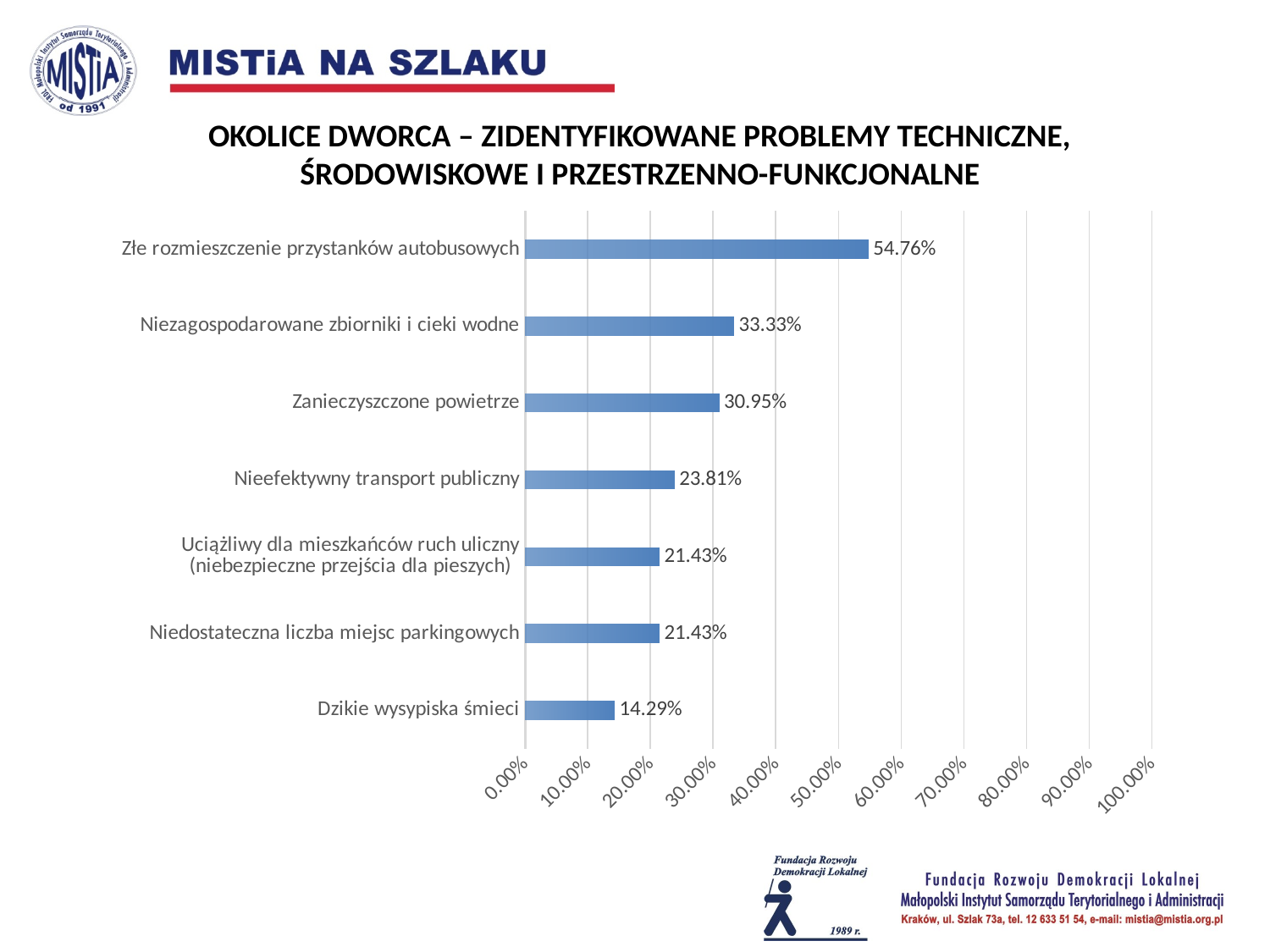
What is the value for "Zanieczyszczone powietrze"? 30.95% Which category has the lowest value? Dzikie wysypiska śmieci What is the difference between the values for "Złe rozmieszczenie przystanków autobusowych" and "Niezagospodarowane zbiorniki i cieki wodne"? 21.43% Which is larger: the value for "Nieefektywny transport publiczny" or the value for "Zanieczyszczone powietrze"? Zanieczyszczone powietrze What is the maximum value shown on the horizontal axis? 100.00% What is the value for "Złe rozmieszczenie przystanków autobusowych"? 54.76% How many categories are shown in the chart? 7 Is the value for "Niezagospodarowane zbiorniki i cieki wodne" greater or less than 30.00%? greater What is the value for "Niedostateczna liczba miejsc parkingowych"? 21.43% What is the value for "Dzikie wysypiska śmieci"? 14.29% Which category has the highest value? Złe rozmieszczenie przystanków autobusowych What kind of chart is shown on the slide? bar chart